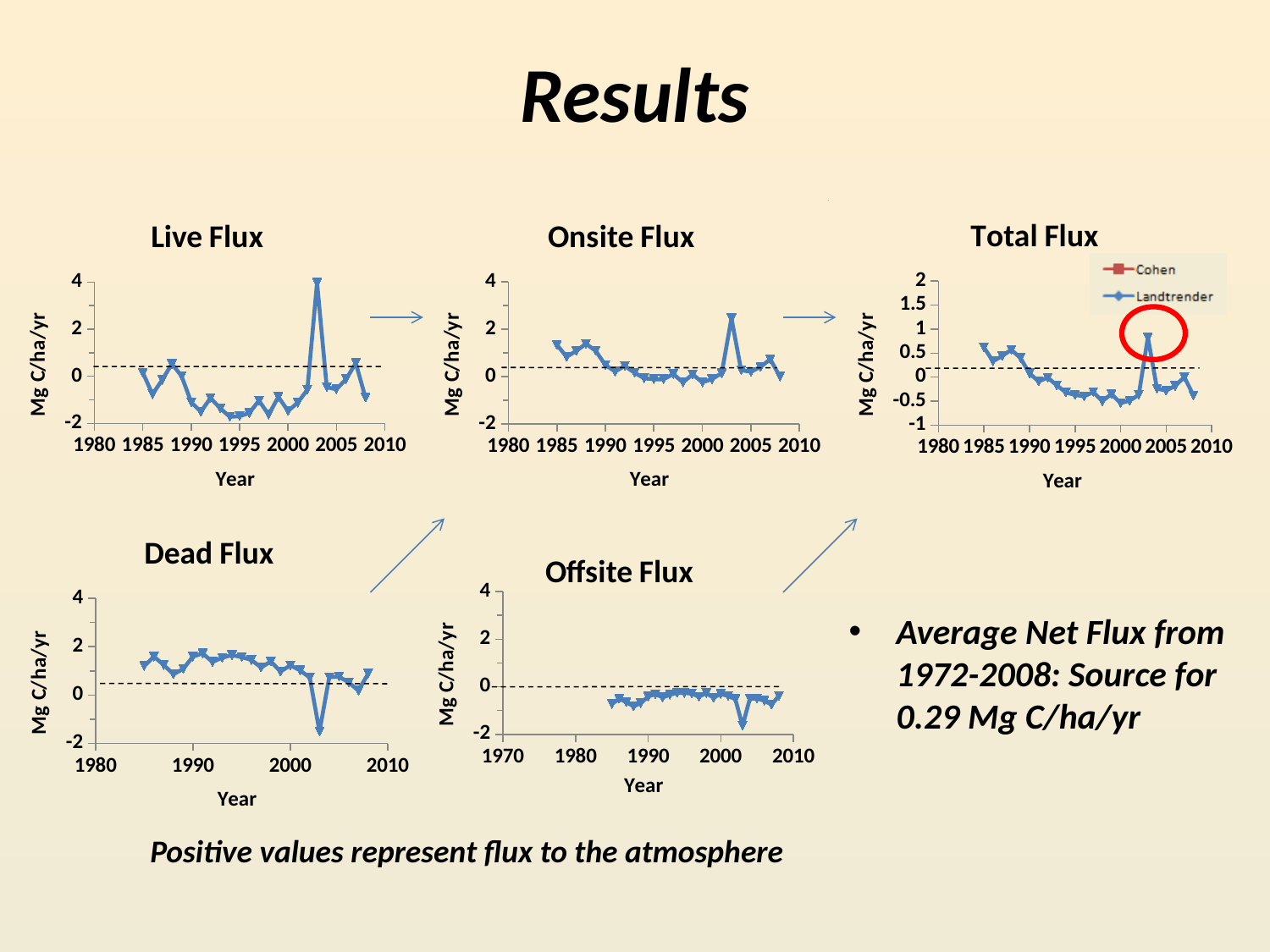
In the Total Flux chart, is the peak value around 2003 greater or less than 0.5? greater In the Total Flux chart, what are the two series named in the legend? Cohen and Landtrender In the Total Flux chart, how many series does the legend list? 2 How many charts are shown on the slide? 5 In the Dead Flux chart, is the value around 1990 greater or less than 0? greater In the Live Flux chart, is the peak value around 2003 greater or less than 2? greater What is the y-axis label on the Live Flux chart? Mg C/ha/yr What kind of chart is the Live Flux chart? line chart In the Live Flux chart, which year is the peak value located at: around 2003 or around 1995? around 2003